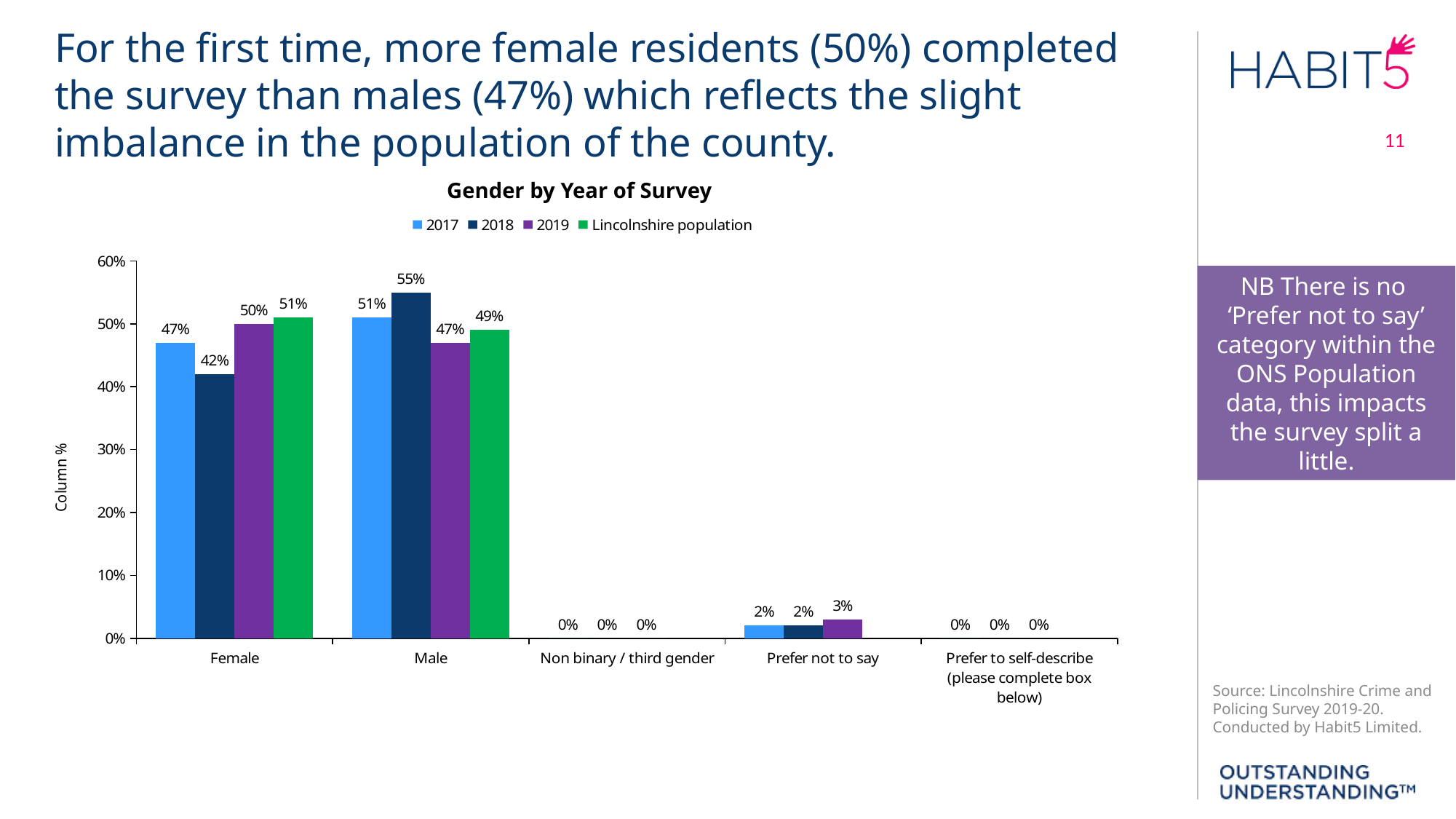
What is the value for Male in the 2018 series? 55% What kind of chart is shown on the slide? Bar chart What is the value for Female in the 2019 series? 50% What is the difference between the 2018 and 2017 values for Male? 4% Which is larger for Female: the 2017 value or the 2019 value? 2019 How many series does the legend list? 4 How many categories are shown on the x axis? 5 What is the Lincolnshire population value for Male? 49% Which year series has the lowest value for Female? 2018 Which category has the highest value in the 2018 series? Male What is the title of the chart? Gender by Year of Survey What is the value for Prefer not to say in the 2019 series? 3%